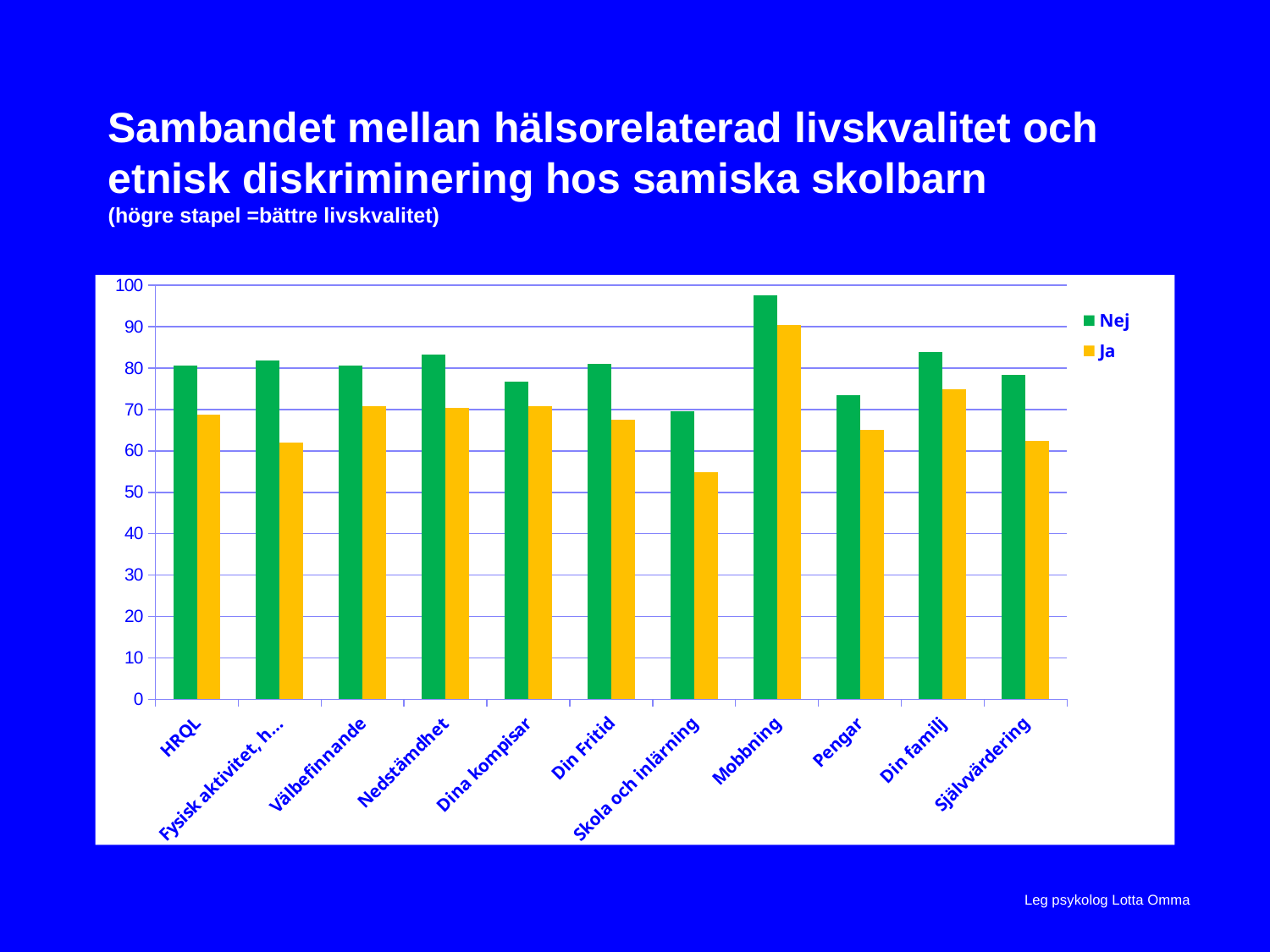
How many categories are shown on the x axis? 11 How many series does the legend list? 2 What kind of chart is shown on the slide? bar chart Is the Ja value for Skola och inlärning greater or less than 60? less Which is larger: the Ja value for Din familj or the Ja value for Pengar? Din familj Is the Nej value for Nedstämdhet greater or less than 80? greater What colour are the bars for the Ja series? yellow Which category has the lowest value for the Nej series? Skola och inlärning Which category has the highest value for the Nej series? Mobbning Which category has the lowest value for the Ja series? Skola och inlärning Is the Nej value for Mobbning greater or less than 90? greater For Din familj, which series has the larger value, Nej or Ja? Nej